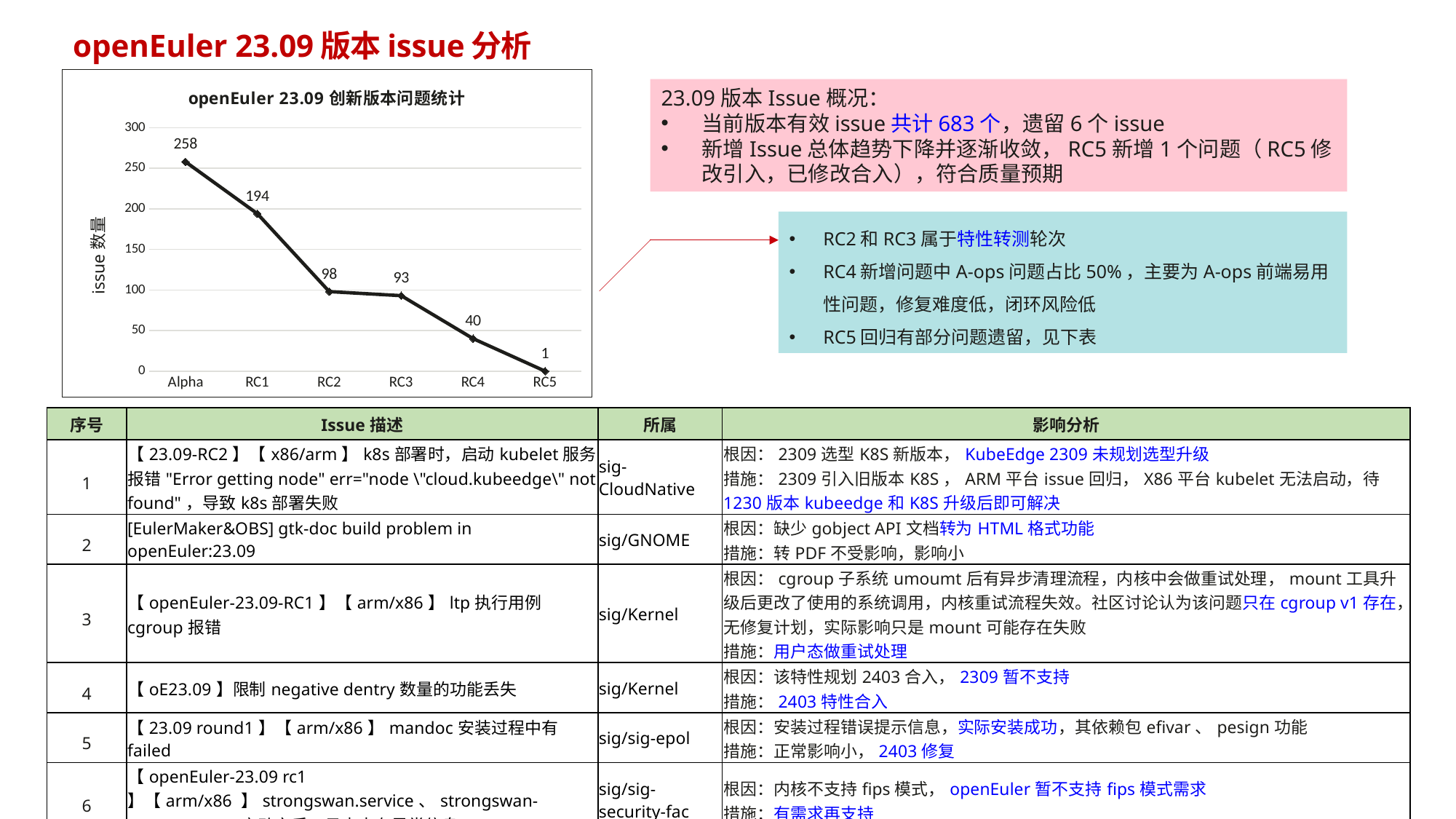
What is the difference in issue count between Alpha and RC1? 64 What is the difference in issue count between RC4 and RC5? 39 What kind of chart is shown? Line chart How many stages are plotted on the x axis? 6 What is the title of the chart? openEuler 23.09 创新版本问题统计 What is the issue count for Alpha? 258 Which stage has the highest issue count? Alpha Which has a higher issue count, RC2 or RC3? RC2 What is the issue count for RC3? 93 Do the issue counts rise or fall from Alpha to RC5? Fall Which stage has the lowest issue count? RC5 What is the issue count for RC5? 1